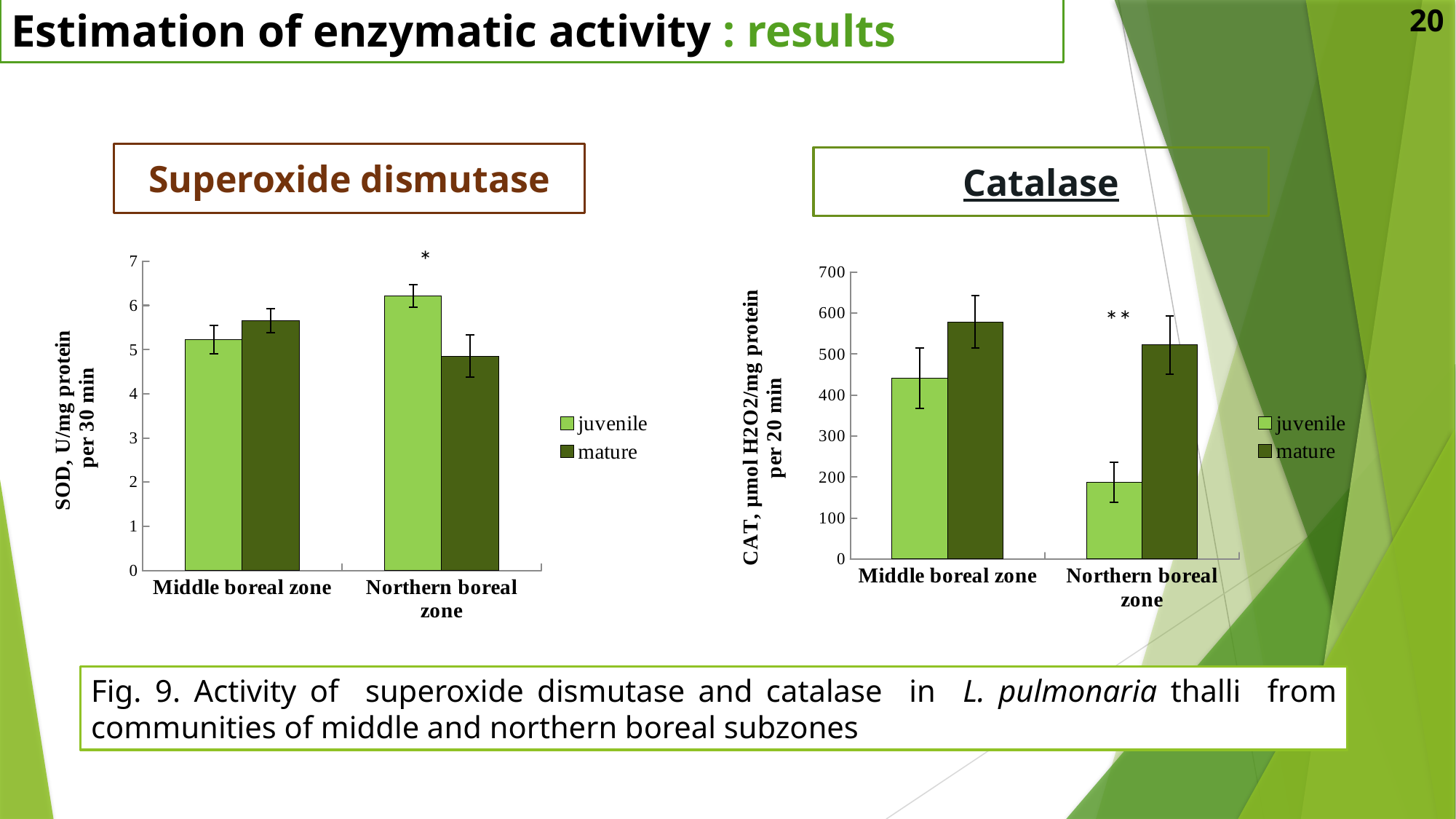
In the Superoxide dismutase chart, is the juvenile value for the Northern boreal zone greater or less than 6? greater In the Catalase chart, is the mature value for the Middle boreal zone greater or less than 500? greater In the Superoxide dismutase chart, which is larger for the Northern boreal zone, juvenile or mature? juvenile What is the y-axis label of the Catalase chart? CAT, µmol H2O2/mg protein per 20 min In the Superoxide dismutase chart, which bar is the highest? juvenile, Northern boreal zone How many series does the legend of the Catalase chart list? 2 In the Superoxide dismutase chart, is the mature value for the Northern boreal zone greater or less than 5? less What kind of chart is the Superoxide dismutase chart? bar chart In the Catalase chart, which bar is the lowest? juvenile, Northern boreal zone In the Catalase chart, which is larger for the Middle boreal zone, juvenile or mature? mature How many zone categories are shown on the x axis of the Superoxide dismutase chart? 2